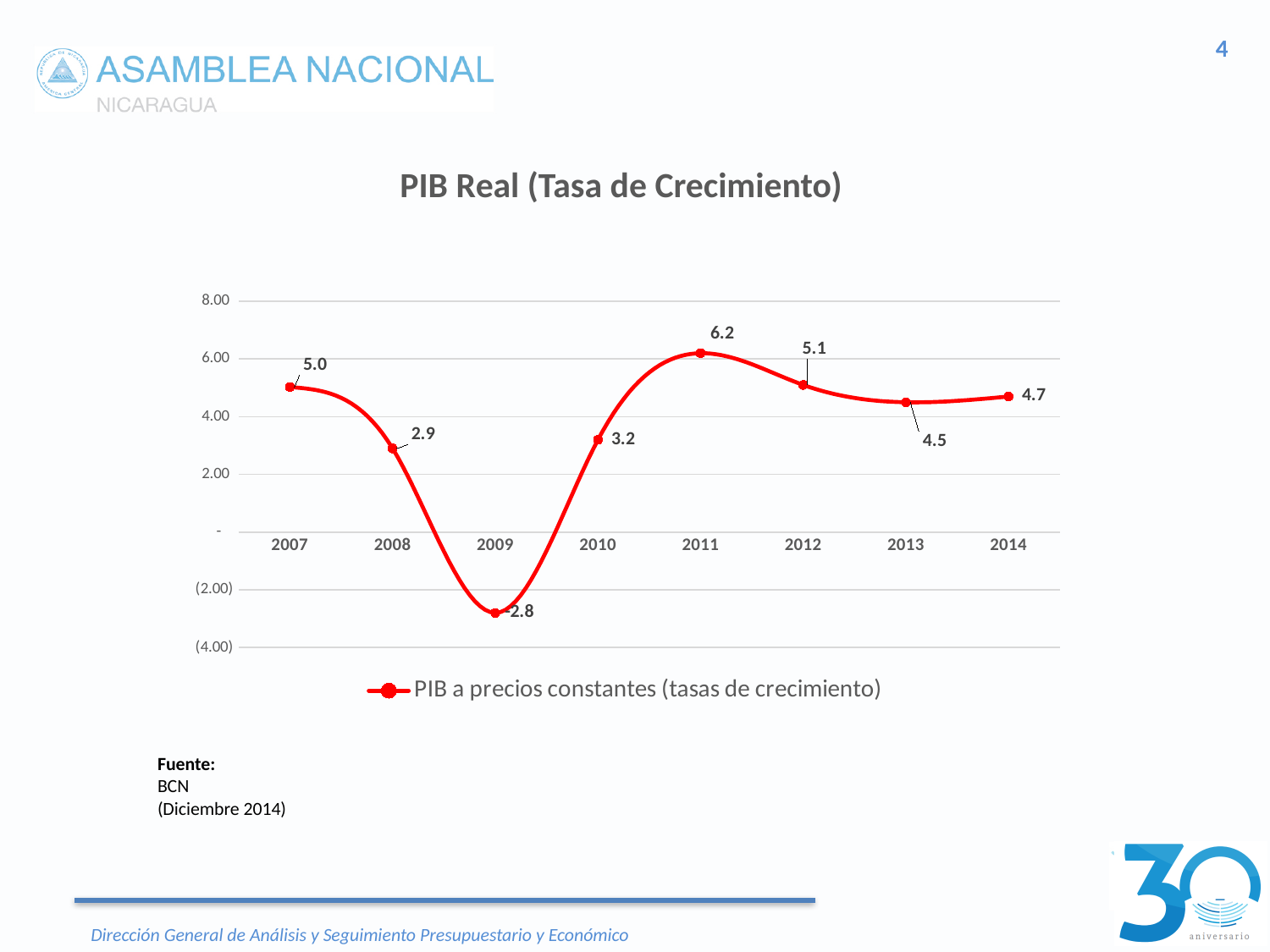
How many years are plotted on the x axis? 8 What is the PIB growth rate value for 2014? 4.7 Which year has the highest PIB growth rate? 2011 What is the PIB growth rate value for 2007? 5.0 What is the PIB growth rate value for 2008? 2.9 Is the value for 2009 greater or less than 0? less What is the difference between the PIB growth rate in 2011 and in 2007? 1.2 What is the title of the chart? PIB Real (Tasa de Crecimiento) What type of chart is shown on the slide? line chart Which year has a higher PIB growth rate, 2012 or 2013? 2012 What is the PIB growth rate value for 2011? 6.2 Which year has the lowest PIB growth rate? 2009